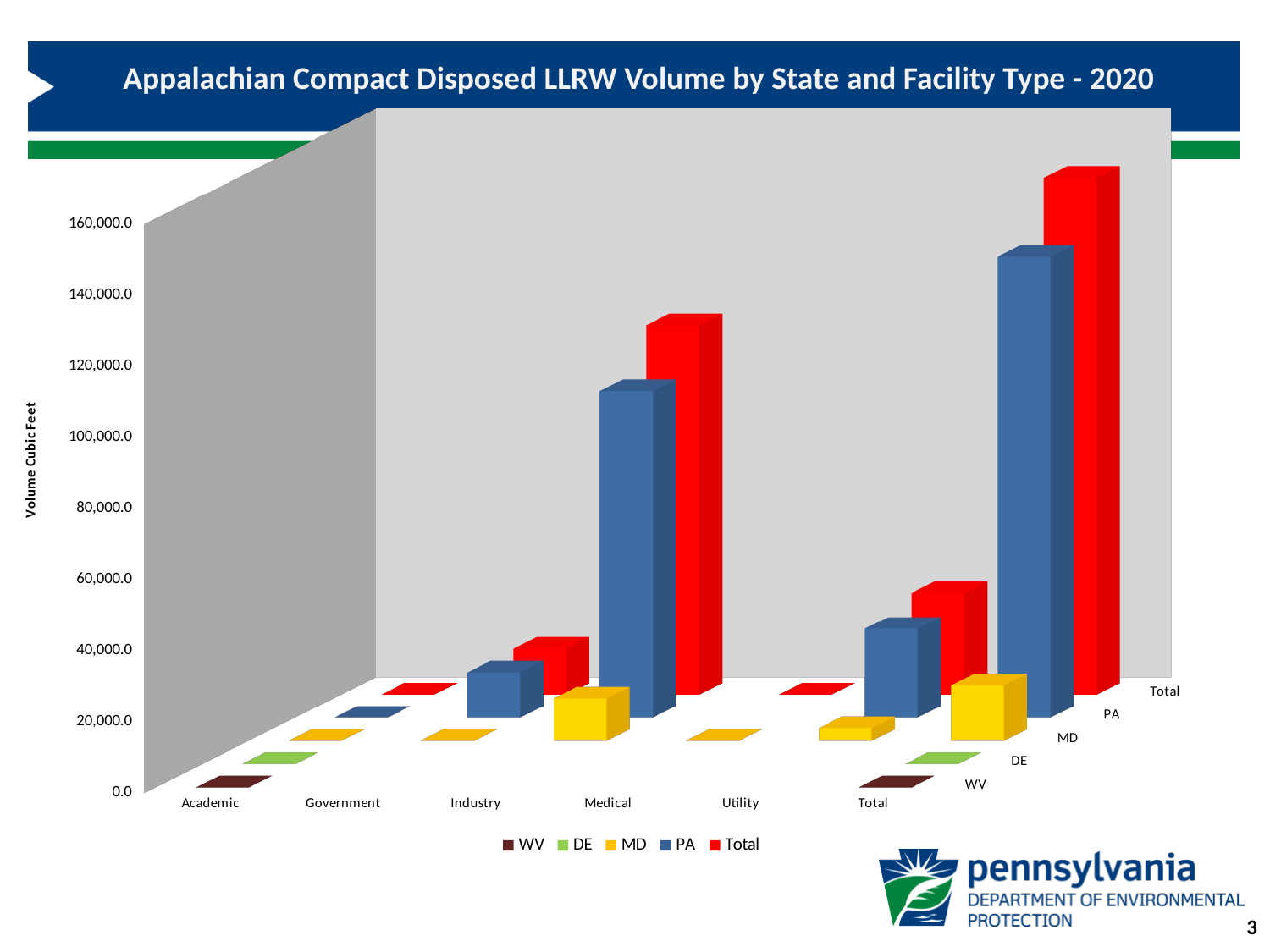
Which is larger, the PA value for Medical or the PA value for Industry? Industry Is the Total value for Medical greater or less than 100,000? less What kind of chart is shown on the slide? bar chart What is the title of the chart? Appalachian Compact Disposed LLRW Volume by State and Facility Type - 2020 Among the facility types (excluding Total), which category has the highest PA value? Industry Is the PA value for Medical greater or less than 80,000? less What is the label of the vertical axis? Volume Cubic Feet How many series does the legend list? 5 Is the PA value for Academic greater or less than 20,000? less Which is larger, the PA value for Total or the PA value for Medical? Total How many categories are shown along the x axis? 6